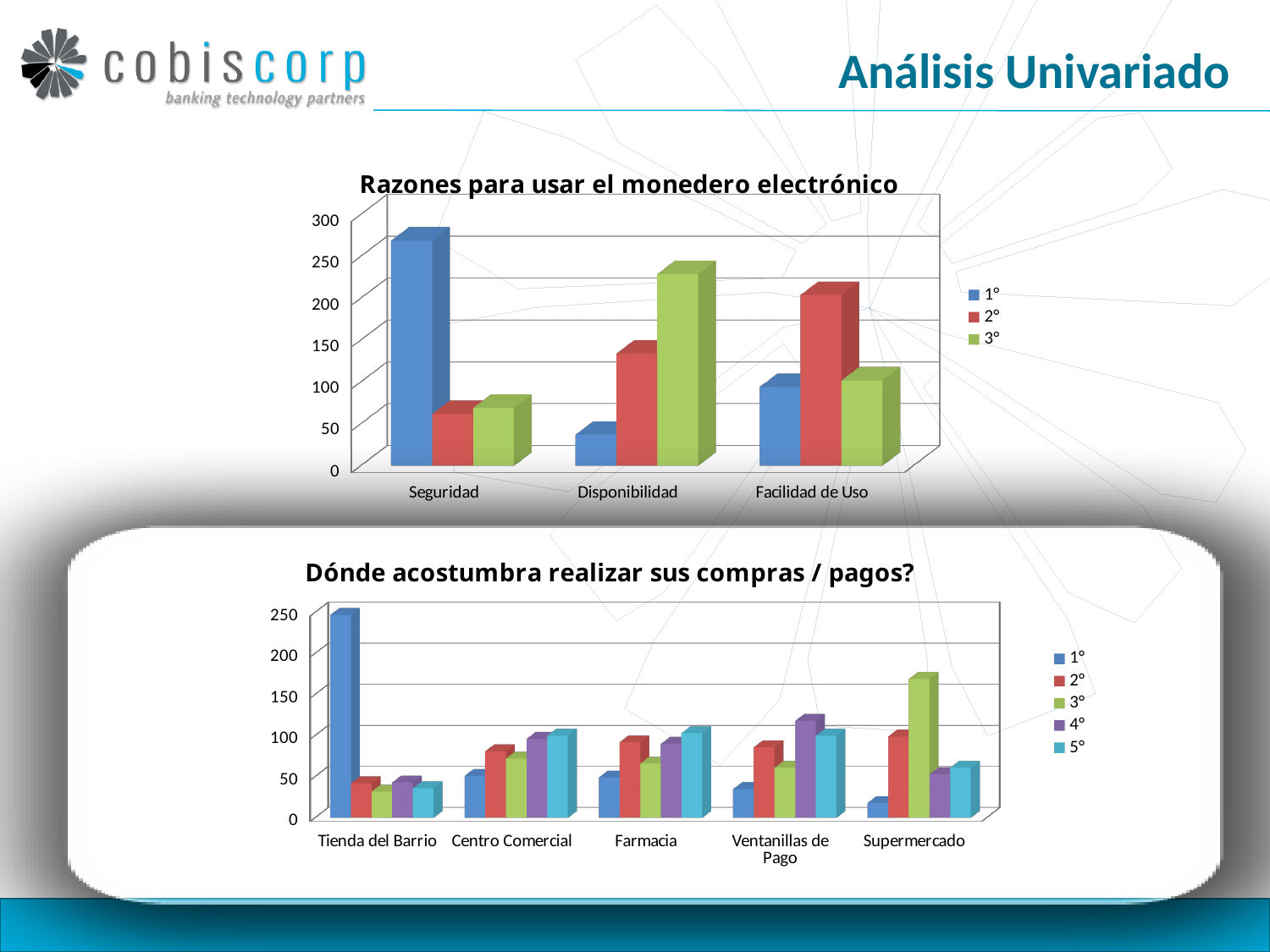
In the 'Dónde acostumbra realizar sus compras / pagos?' chart, which category has the lowest 1° bar? Supermercado In the 'Razones para usar el monedero electrónico' chart, which category has the highest 3° bar? Disponibilidad How many series does the legend of the 'Razones para usar el monedero electrónico' chart list? 3 How many categories are shown on the x axis of the 'Razones para usar el monedero electrónico' chart? 3 In the 'Dónde acostumbra realizar sus compras / pagos?' chart, is the 1° value for Tienda del Barrio greater or less than 200? greater How many series does the legend of the 'Dónde acostumbra realizar sus compras / pagos?' chart list? 5 In the 'Razones para usar el monedero electrónico' chart, is the 1° value for Seguridad greater or less than 250? greater In the 'Razones para usar el monedero electrónico' chart, which is larger for Facilidad de Uso: the 1° bar or the 2° bar? 2° In the 'Razones para usar el monedero electrónico' chart, which category has the lowest 1° bar? Disponibilidad In the 'Dónde acostumbra realizar sus compras / pagos?' chart, which category has the highest 3° bar? Supermercado What kind of chart is 'Razones para usar el monedero electrónico'? bar chart How many categories are shown on the x axis of the 'Dónde acostumbra realizar sus compras / pagos?' chart? 5